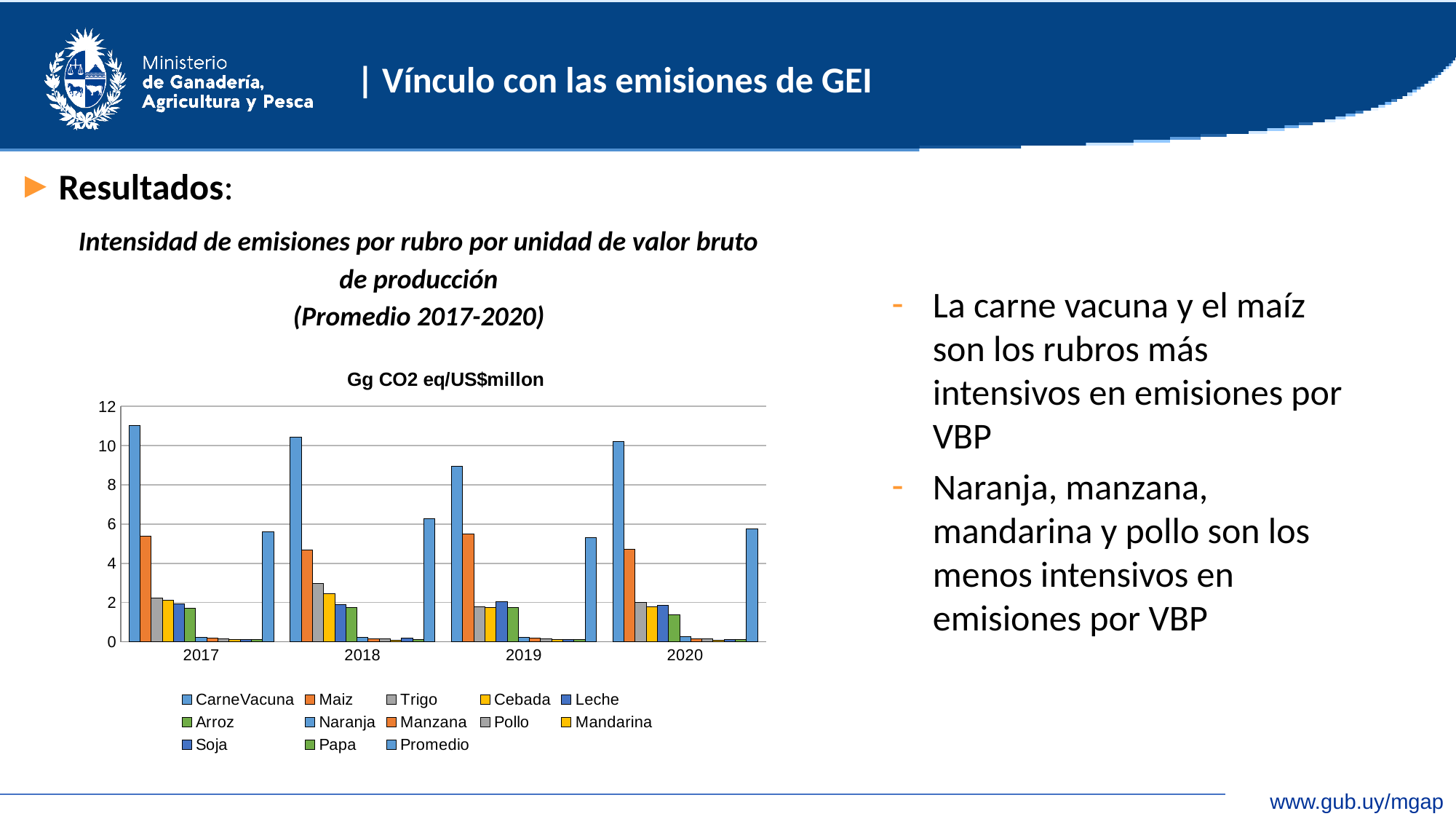
Which series has the highest value in 2019? CarneVacuna Is the value for CarneVacuna in 2017 greater or less than 10? greater Is the value for Maiz in 2017 greater or less than 4? greater In 2020, which is larger: the value for CarneVacuna or the value for Maiz? CarneVacuna In 2018, which is larger: the value for Promedio or the value for Maiz? Promedio What kind of chart is shown on the slide? bar chart How many years (categories) are shown on the x axis of the chart? 4 What unit is given in the title above the chart's plot area? Gg CO2 eq/US$millon Which series has the highest value in 2017? CarneVacuna How many series does the chart's legend list? 13 Is the value for CarneVacuna in 2019 greater or less than 10? less